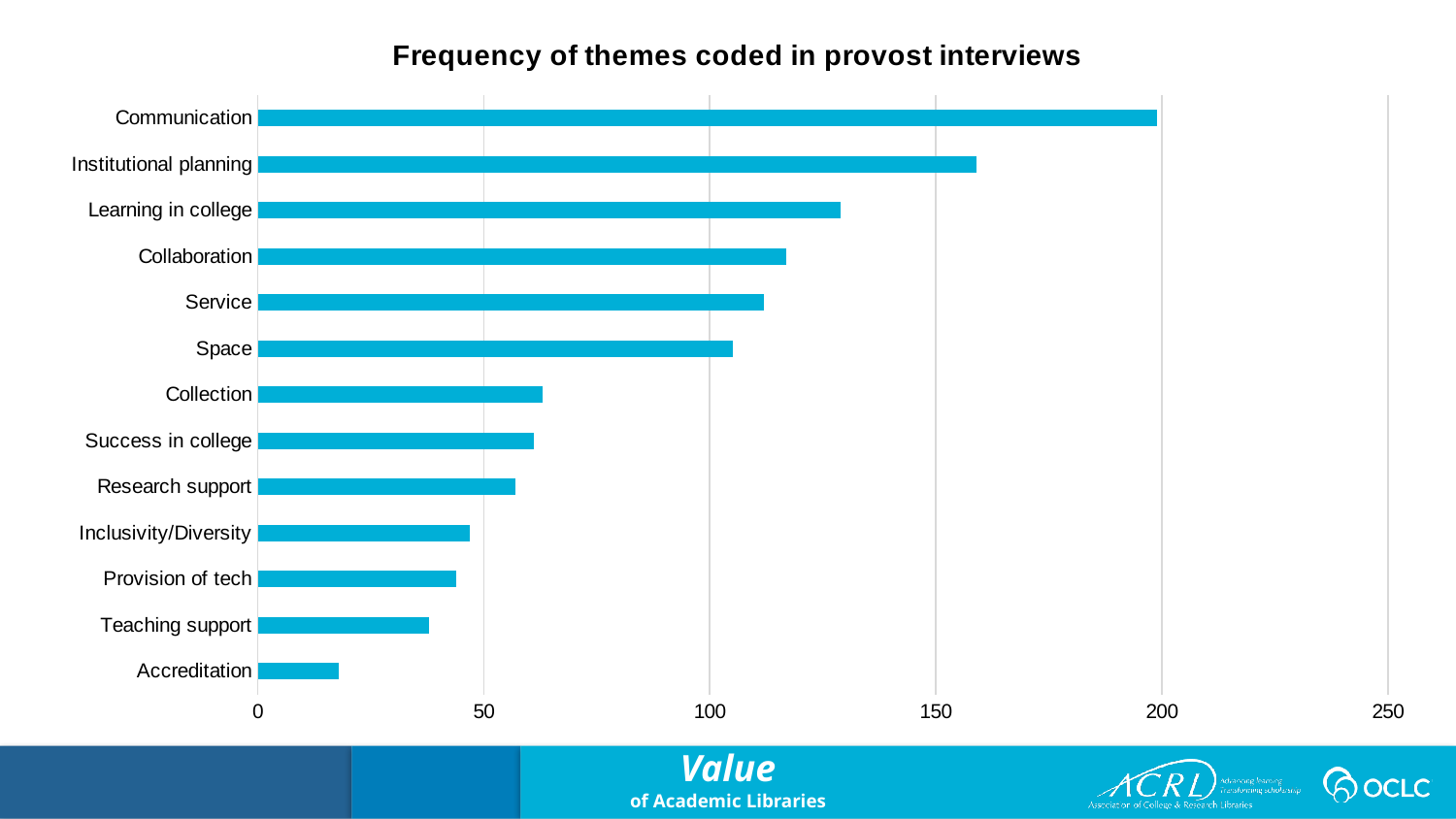
Is the value for Learning in college greater or less than 150? less Which theme has the highest frequency? Communication Which has a higher frequency, Communication or Institutional planning? Communication Is the value for Space greater or less than 100? greater Which theme has the lowest frequency? Accreditation What type of chart is shown on the slide? bar chart What is the title of the chart? Frequency of themes coded in provost interviews Is the value for Teaching support greater or less than 50? less How many themes (categories) are plotted in the chart? 13 Which has a higher frequency, Space or Collection? Space